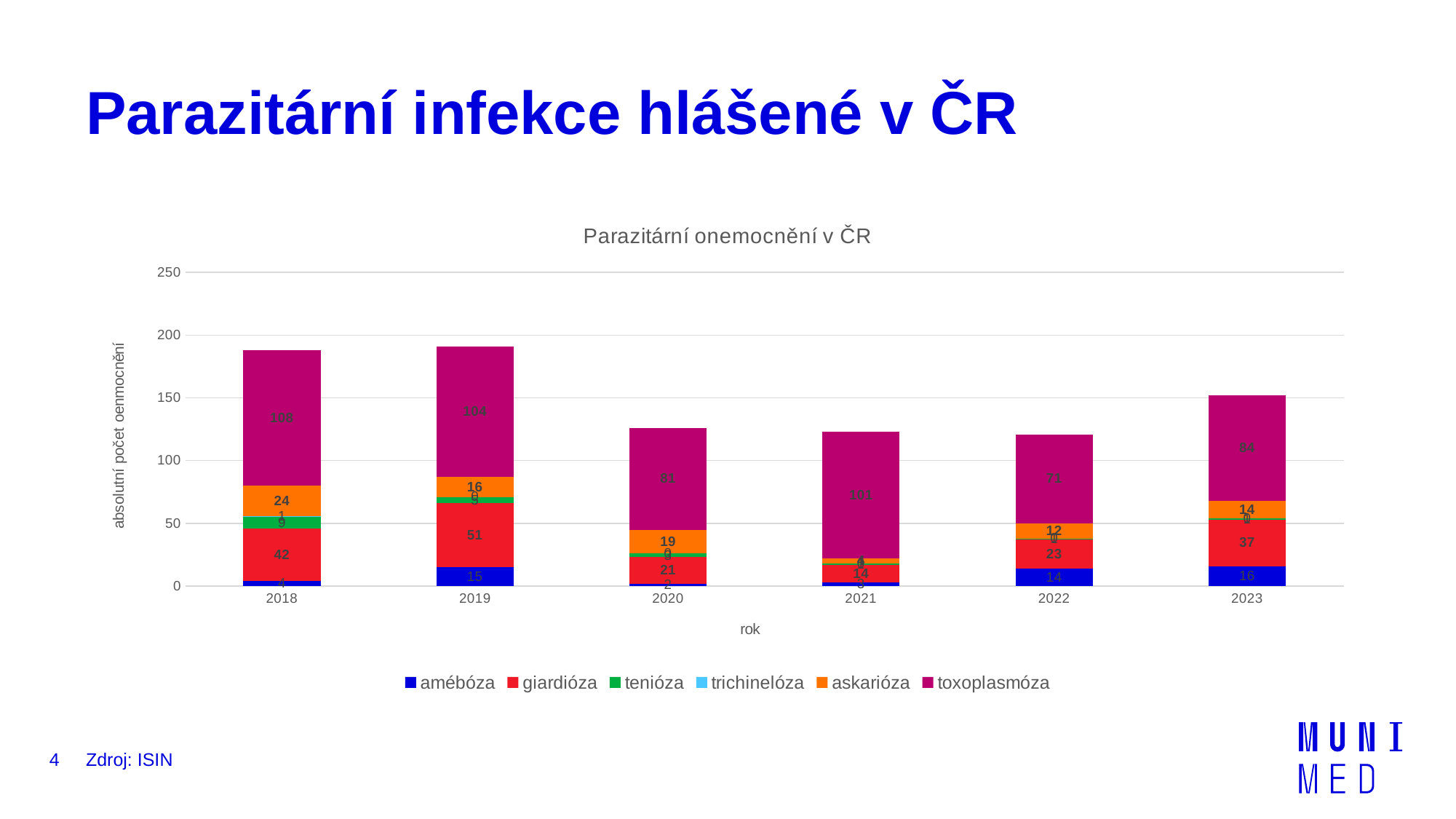
What kind of chart is shown on the slide? stacked bar chart What is the value for askarióza in 2022? 12 How many years are shown on the x axis? 6 What is the value for giardióza in 2019? 51 Which year has the larger giardióza value, 2018 or 2023? 2018 Is the total height of the 2019 bar greater or less than 150? greater What is the label of the x axis? rok In which year is the toxoplasmóza value lowest? 2022 In which year is the toxoplasmóza value highest? 2018 What is the difference between the toxoplasmóza values in 2018 and 2022? 37 What is the value for toxoplasmóza in 2018? 108 How many series does the legend list? 6